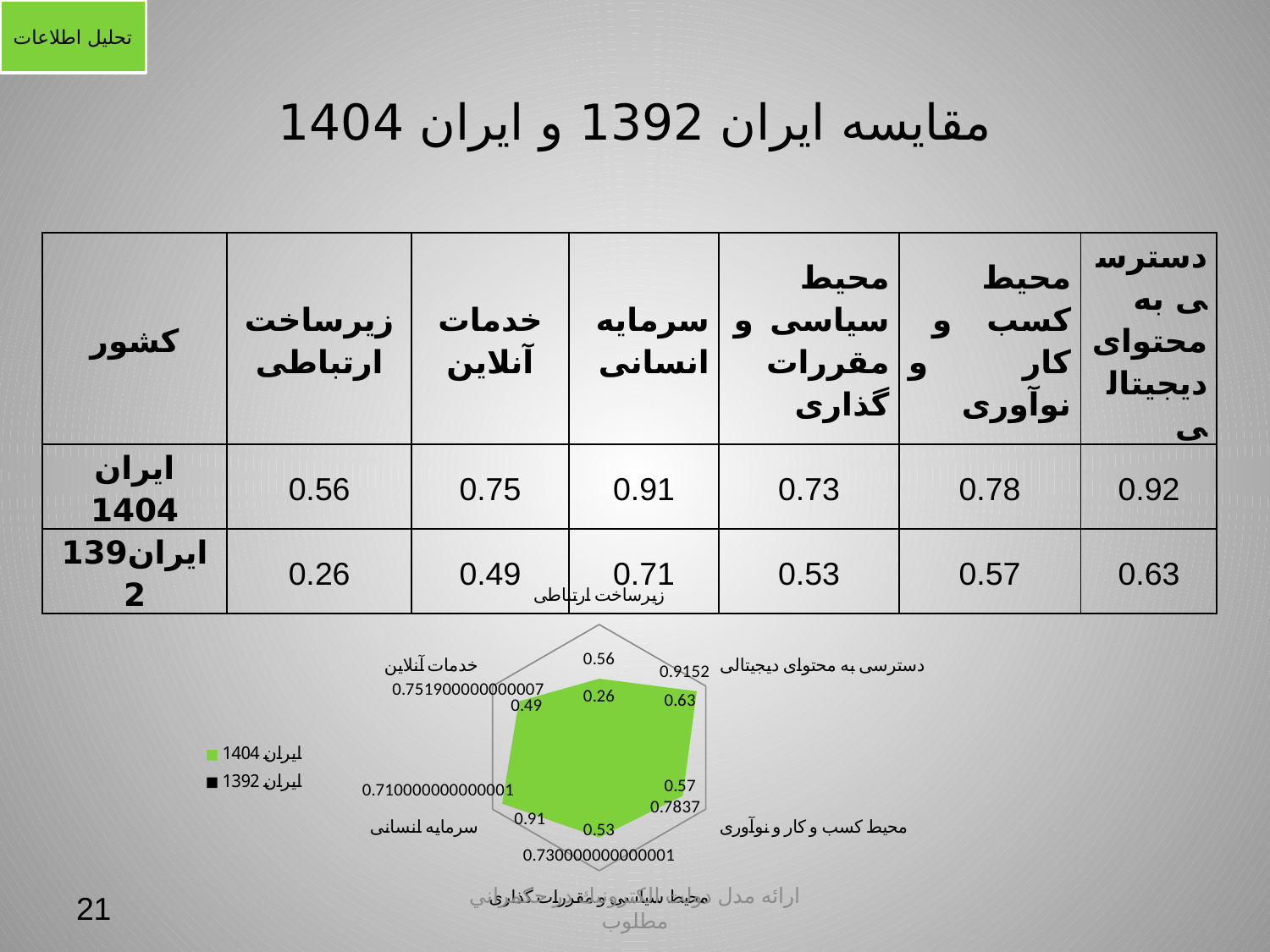
In the radar chart, what is the value of ایران 1404 for دسترسی به محتوای دیجیتالی? 0.9152 In the radar chart, what is the difference between the ایران 1404 and ایران 1392 values for زیرساخت ارتباطی? 0.30 In the radar chart, which category has the lowest value for ایران 1392? زیرساخت ارتباطی Which colour represents ایران 1404 in the chart legend? Green In the radar chart, what is the value of ایران 1392 for محیط کسب و کار و نوآوری? 0.57 How many categories (axes) does the radar chart have? 6 In the radar chart, what is the value of ایران 1404 for زیرساخت ارتباطی? 0.56 In the radar chart, which category has the highest value for ایران 1404? دسترسی به محتوای دیجیتالی In the radar chart, which series has the larger value for زیرساخت ارتباطی, ایران 1404 or ایران 1392? ایران 1404 How many series does the chart legend list? 2 In the radar chart, what is the value of ایران 1392 for زیرساخت ارتباطی? 0.26 What kind of chart is shown at the bottom of the slide? Radar chart